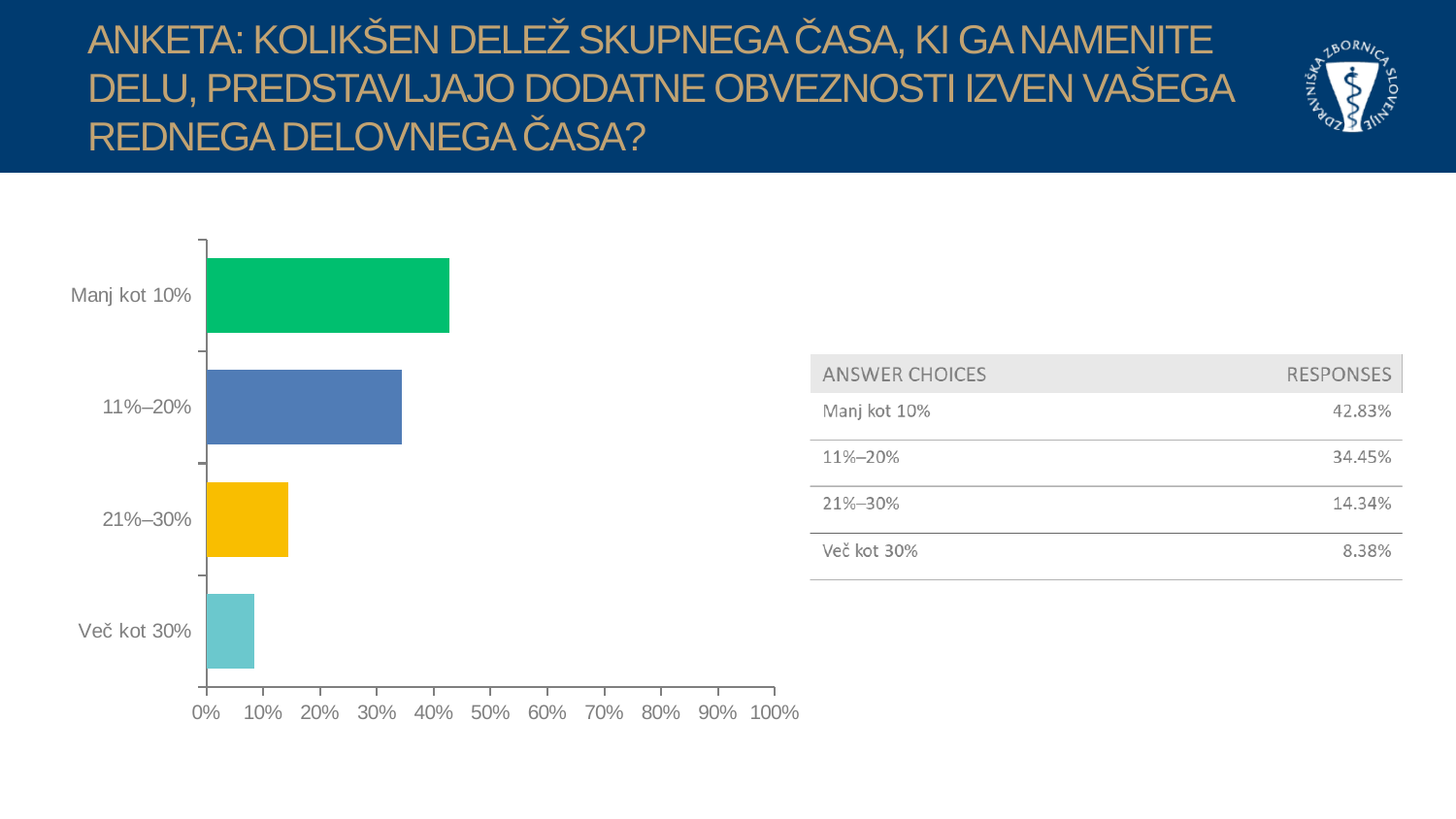
What is the response share for 'Manj kot 10%' according to the table? 42.83% Which category has the highest value in the bar chart? Manj kot 10% What is the response share for 'Več kot 30%' according to the table? 8.38% Which category has the lowest value in the bar chart? Več kot 30% Is the value for 'Več kot 30%' greater or less than 10%? less What kind of chart is shown on the slide? bar chart Is the value for 'Manj kot 10%' greater or less than 40%? greater What is the response share for '21%–30%' according to the table? 14.34% How many categories does the bar chart show? 4 What is the difference between the values for 'Manj kot 10%' and '11%–20%'? 8.38% What is the response share for '11%–20%' according to the table? 34.45% Which is larger, the value for '11%–20%' or the value for '21%–30%'? 11%–20%